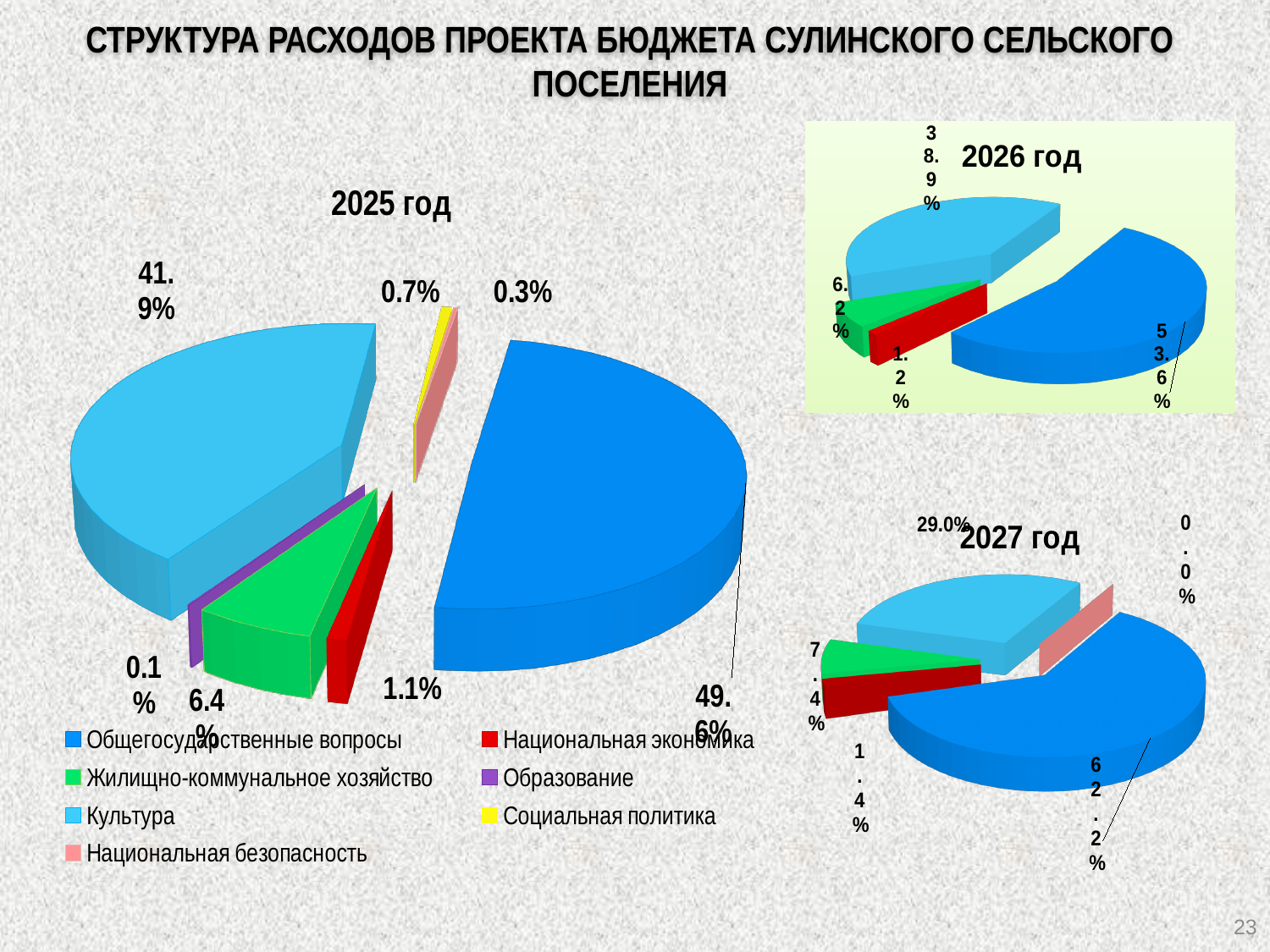
In the 2025 год chart, what is the difference between the shares of Общегосударственные вопросы and Культура? 7.7% In the 2027 год chart, what share is shown for Жилищно-коммунальное хозяйство? 7.4% Which is larger: the share of Общегосударственные вопросы in the 2026 год chart or in the 2027 год chart? 2027 год In the 2025 год chart, what share is shown for Общегосударственные вопросы? 49.6% In the 2026 год chart, what share is shown for Культура? 38.9% In the 2026 год chart, what share is shown for Общегосударственные вопросы? 53.6% In the 2027 год chart, what share is shown for Общегосударственные вопросы? 62.2% In the 2025 год chart, what share is shown for Жилищно-коммунальное хозяйство? 6.4% In the 2025 год chart, what share is shown for Культура? 41.9% What type of charts are shown on the slide? pie charts In the 2025 год chart, which category has the largest share? Общегосударственные вопросы How many series does the legend list? 7